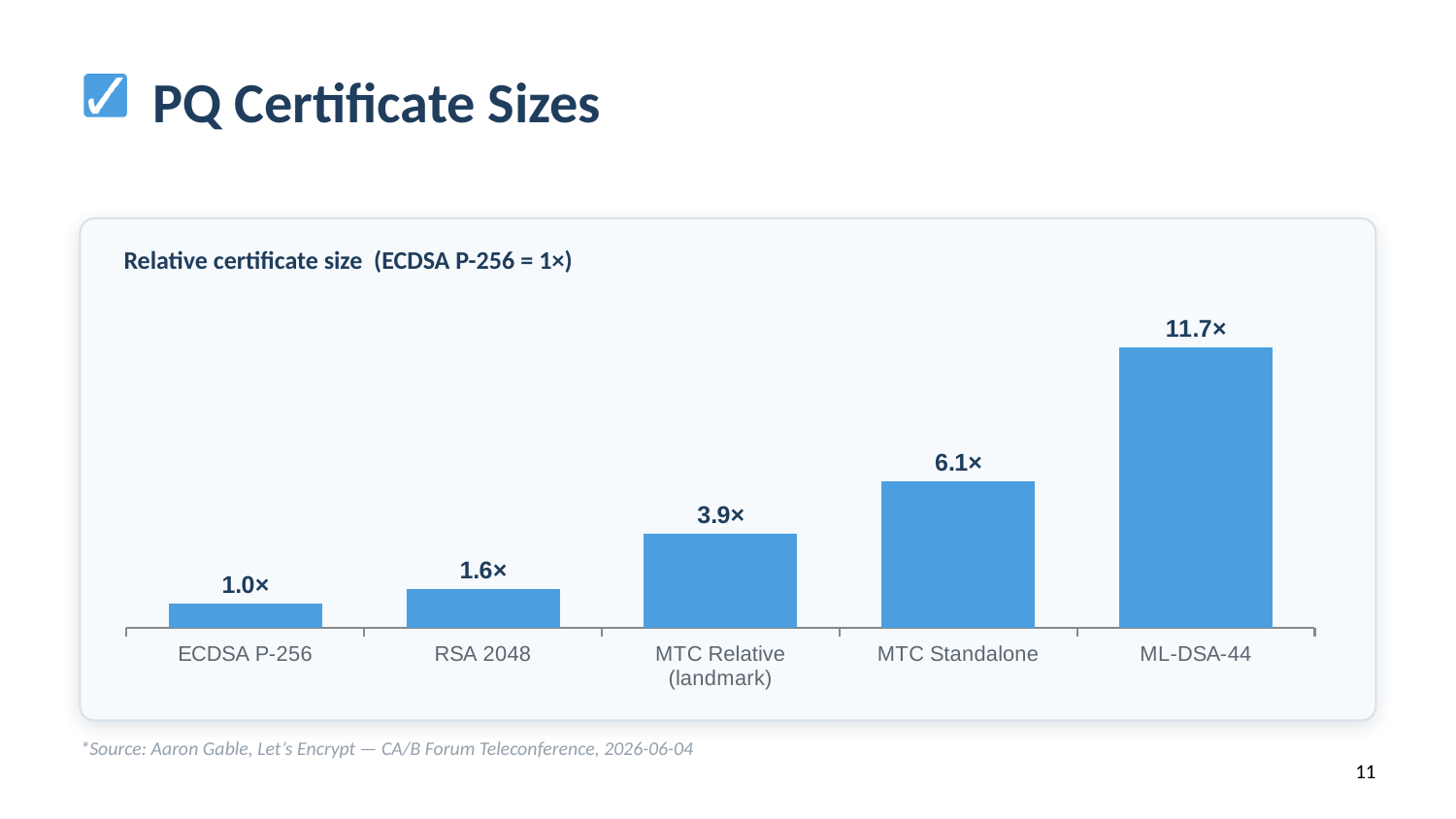
What is the difference between the relative certificate sizes of MTC Relative (landmark) and RSA 2048? 2.3× What is the relative certificate size for ML-DSA-44? 11.7× Which category has the largest relative certificate size? ML-DSA-44 What is the difference between the relative certificate sizes of ML-DSA-44 and MTC Standalone? 5.6× What is the relative certificate size for MTC Standalone? 6.1× What is the relative certificate size for MTC Relative (landmark)? 3.9× What is the relative certificate size for RSA 2048? 1.6× What kind of chart is shown on the slide? Bar chart How many categories are shown in the chart? 5 Do the values rise or fall from left to right across the categories? Rise Which category has the smallest relative certificate size? ECDSA P-256 Which has a larger relative certificate size, MTC Standalone or MTC Relative (landmark)? MTC Standalone